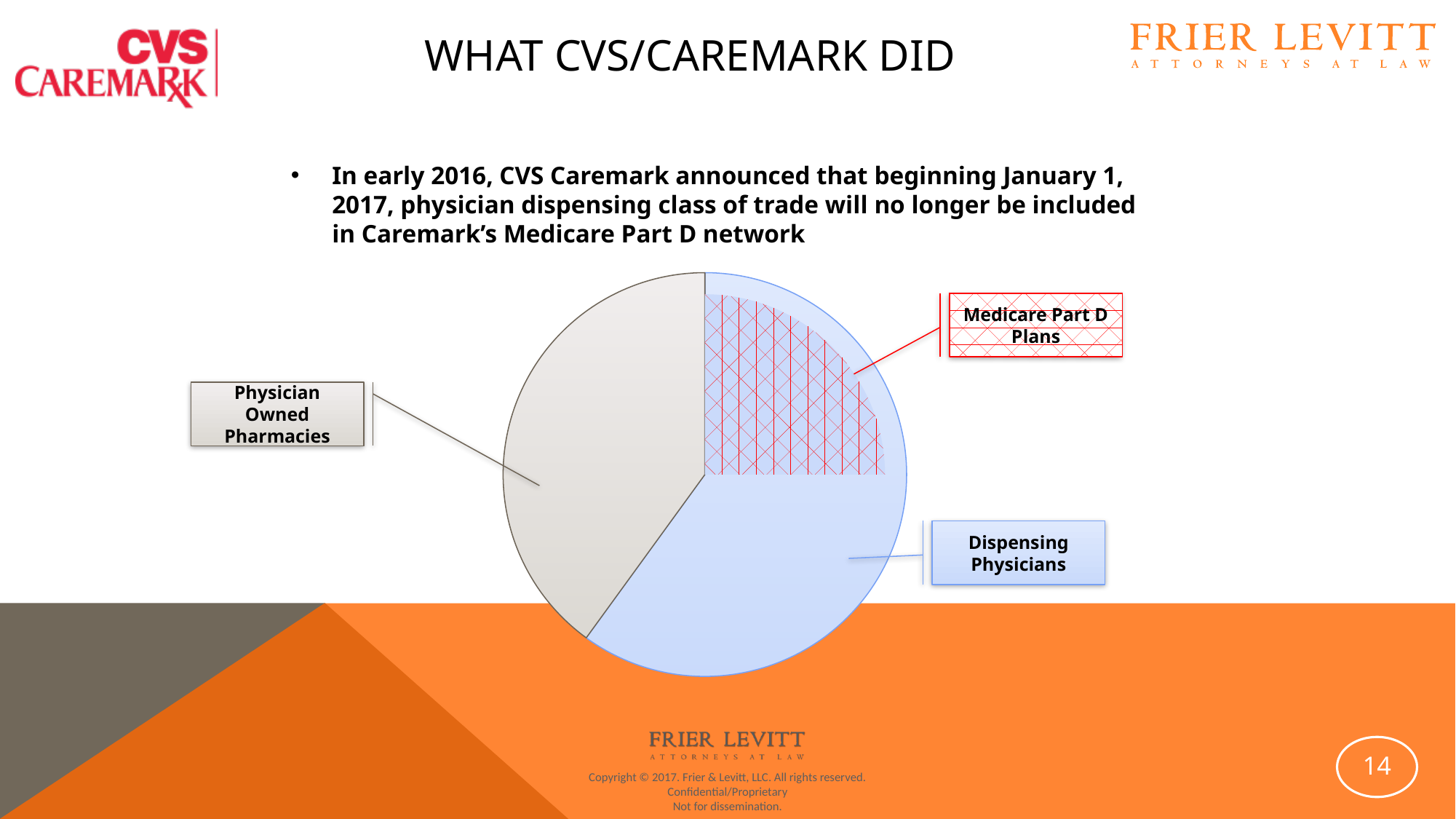
What label is attached to the grey slice of the pie chart? Physician Owned Pharmacies How many slices does the pie chart have? 2 Which slice of the pie chart is the largest? Dispensing Physicians Which slice of the pie chart is larger, Dispensing Physicians or Physician Owned Pharmacies? Dispensing Physicians Which slice of the pie chart is the smallest? Physician Owned Pharmacies Does the Dispensing Physicians slice take up more or less than half of the pie chart? More What kind of chart is shown on the slide? Pie chart What label is attached to the hatched region overlaid on the blue slice of the pie chart? Medicare Part D Plans